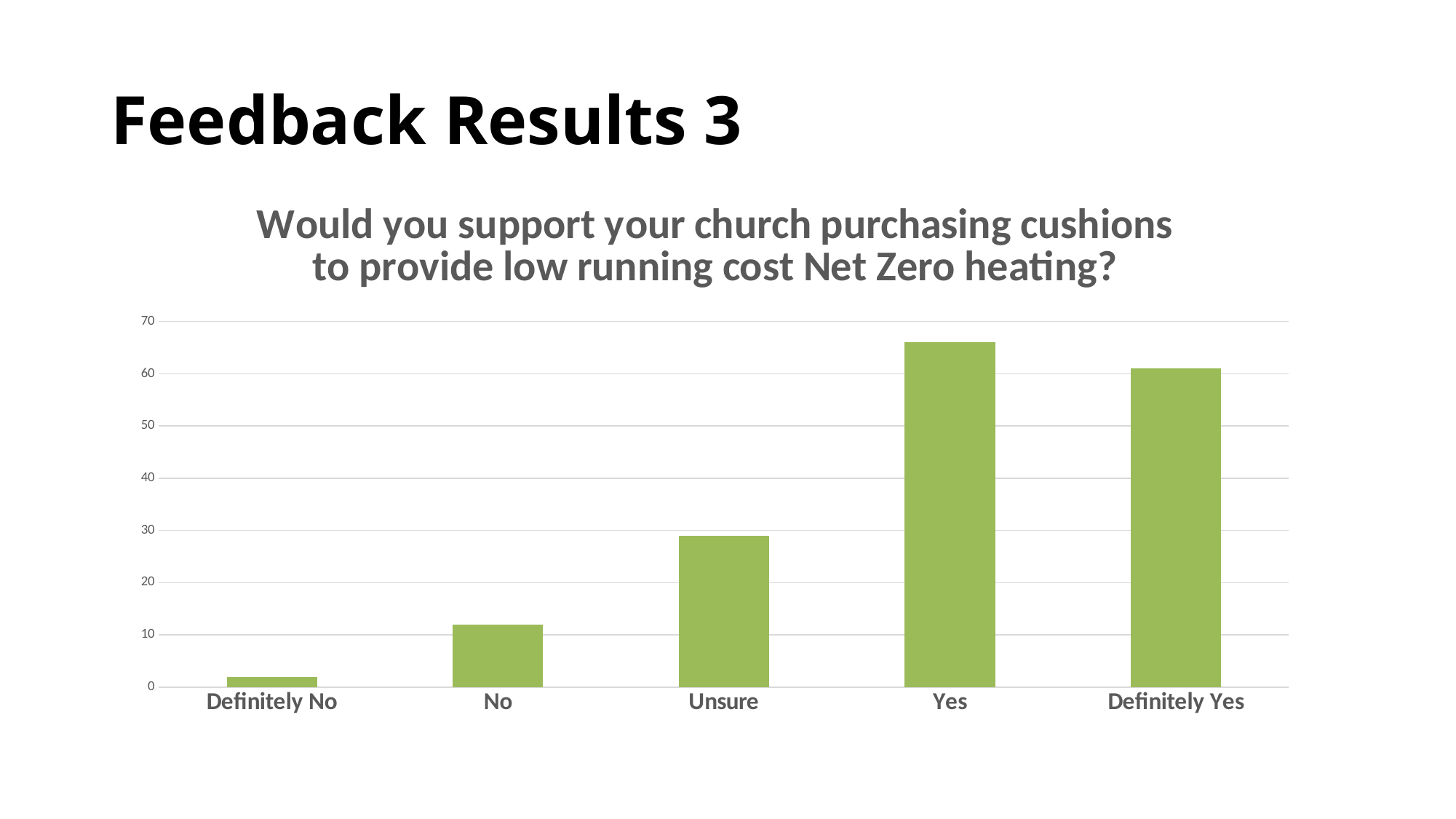
Which response category has the highest bar? Yes Which is larger, the value for No or the value for Definitely No? No What is the title of the chart? Would you support your church purchasing cushions to provide low running cost Net Zero heating? Is the value for No greater or less than 10? greater Is the value for Yes greater or less than 70? less Which response category has the lowest bar? Definitely No Which is larger, the value for Yes or the value for Unsure? Yes How many response categories are shown on the x axis? 5 What kind of chart is shown on the slide? bar chart Is the value for Unsure greater or less than 20? greater